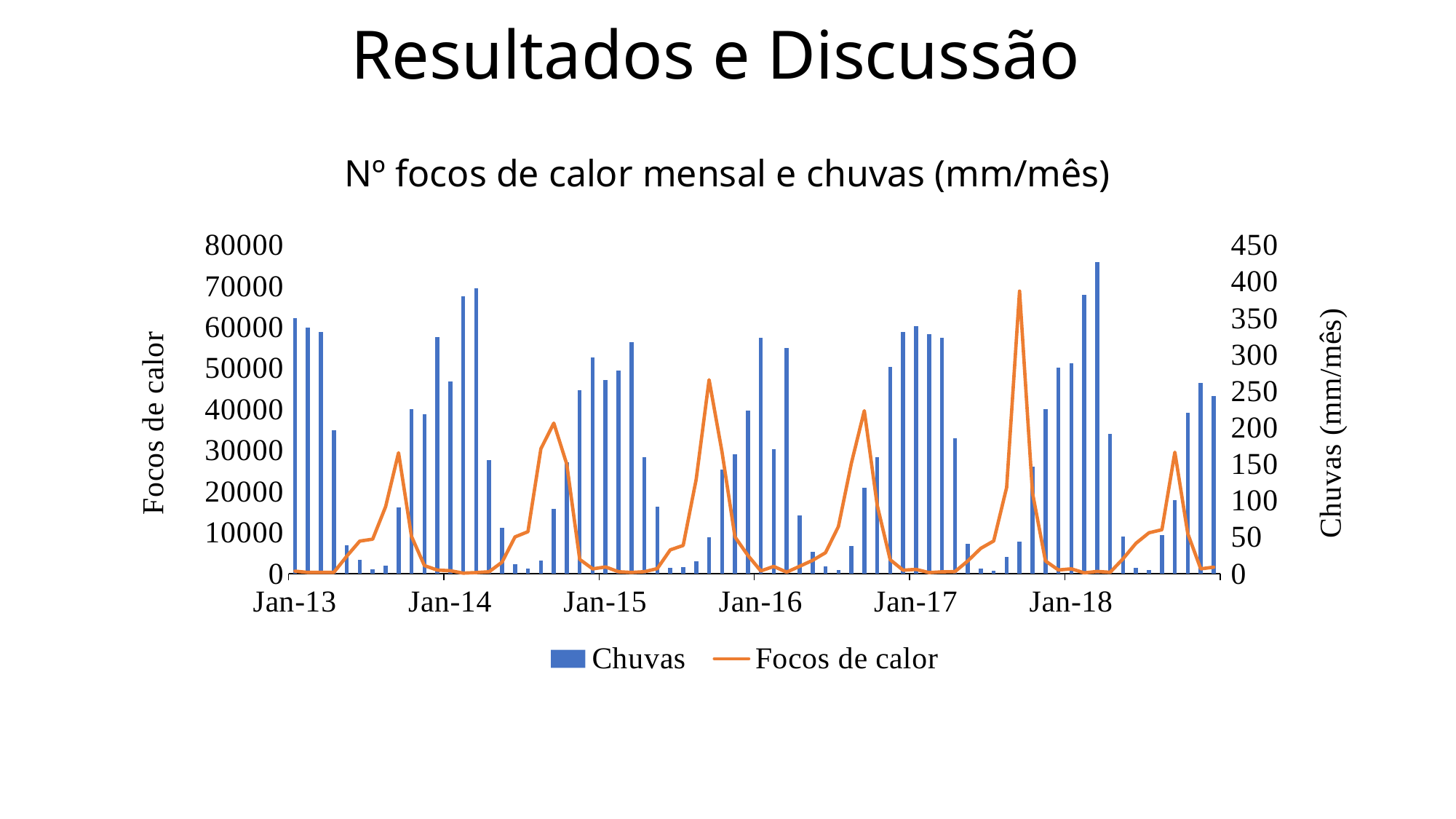
How many year labels are shown on the x axis? 6 Does the Focos de calor line show a steady rise, a steady fall, or a repeating seasonal pattern of peaks along the x axis? A repeating seasonal pattern of peaks Between which two x-axis labels is the tallest Chuvas bar located? After Jan-18 What kind of chart is shown on the slide? A combination bar and line chart Which series is drawn as bars and which as a line? Chuvas as bars, Focos de calor as a line What is the title of the chart? Nº focos de calor mensal e chuvas (mm/mês) Between which two x-axis labels does the Focos de calor line reach its highest peak? Between Jan-17 and Jan-18 How many series does the legend list? 2